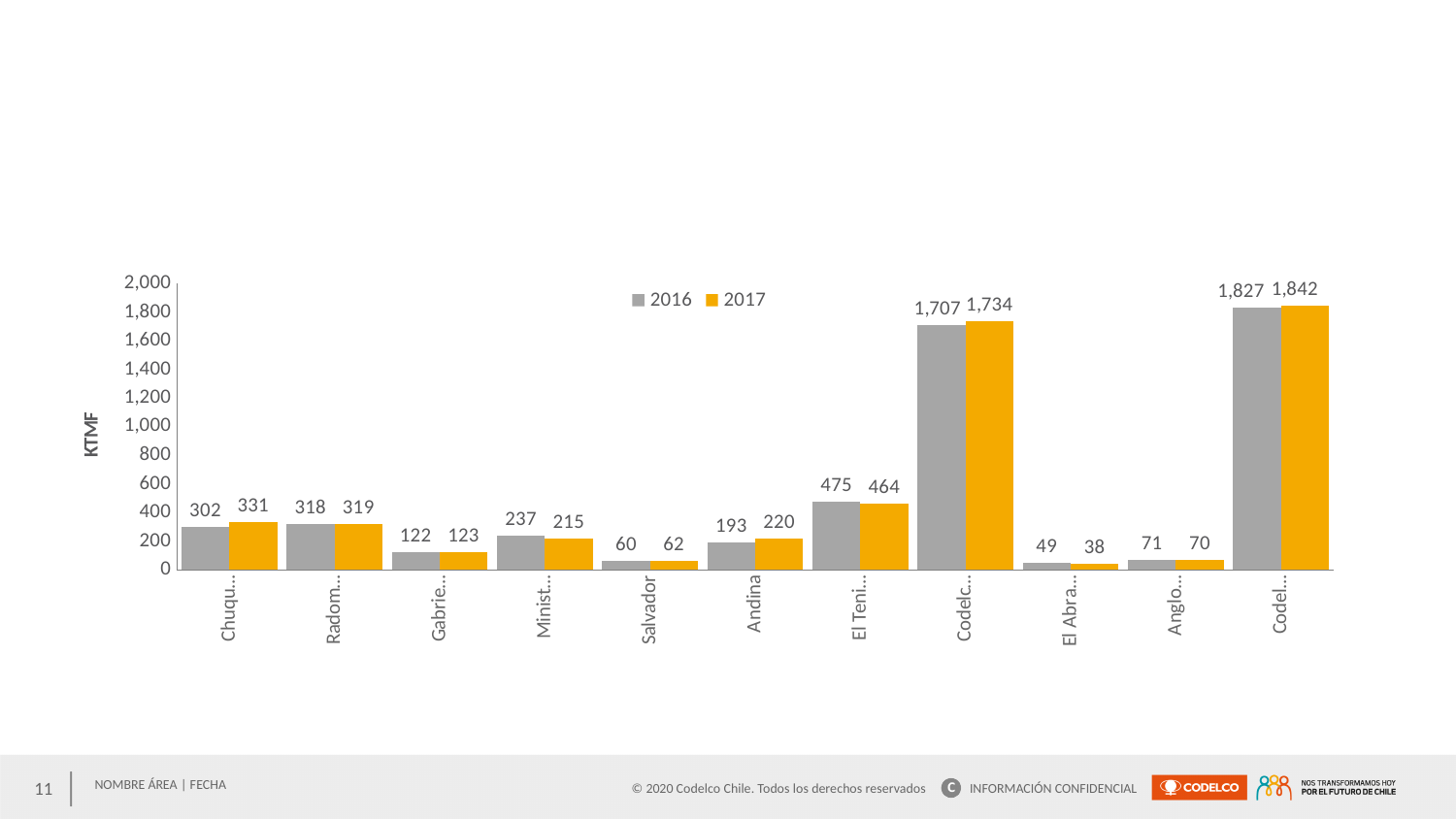
How many categories are shown on the x axis of the chart? 11 What is the value for Andina in 2016? 193 By how much did the value for Andina change from 2016 to 2017? 27 What is the value for Salvador in 2017? 62 What kind of chart is shown on the slide? bar chart Is the 2017 value for Andina greater or less than 400? less What is the difference between the 2017 and 2016 values for Salvador? 2 What is the value for Andina in 2017? 220 How many series does the legend list? 2 For Andina, which year has the higher value, 2016 or 2017? 2017 Which is larger in 2016, the value for Andina or the value for Salvador? Andina What is the value for Salvador in 2016? 60